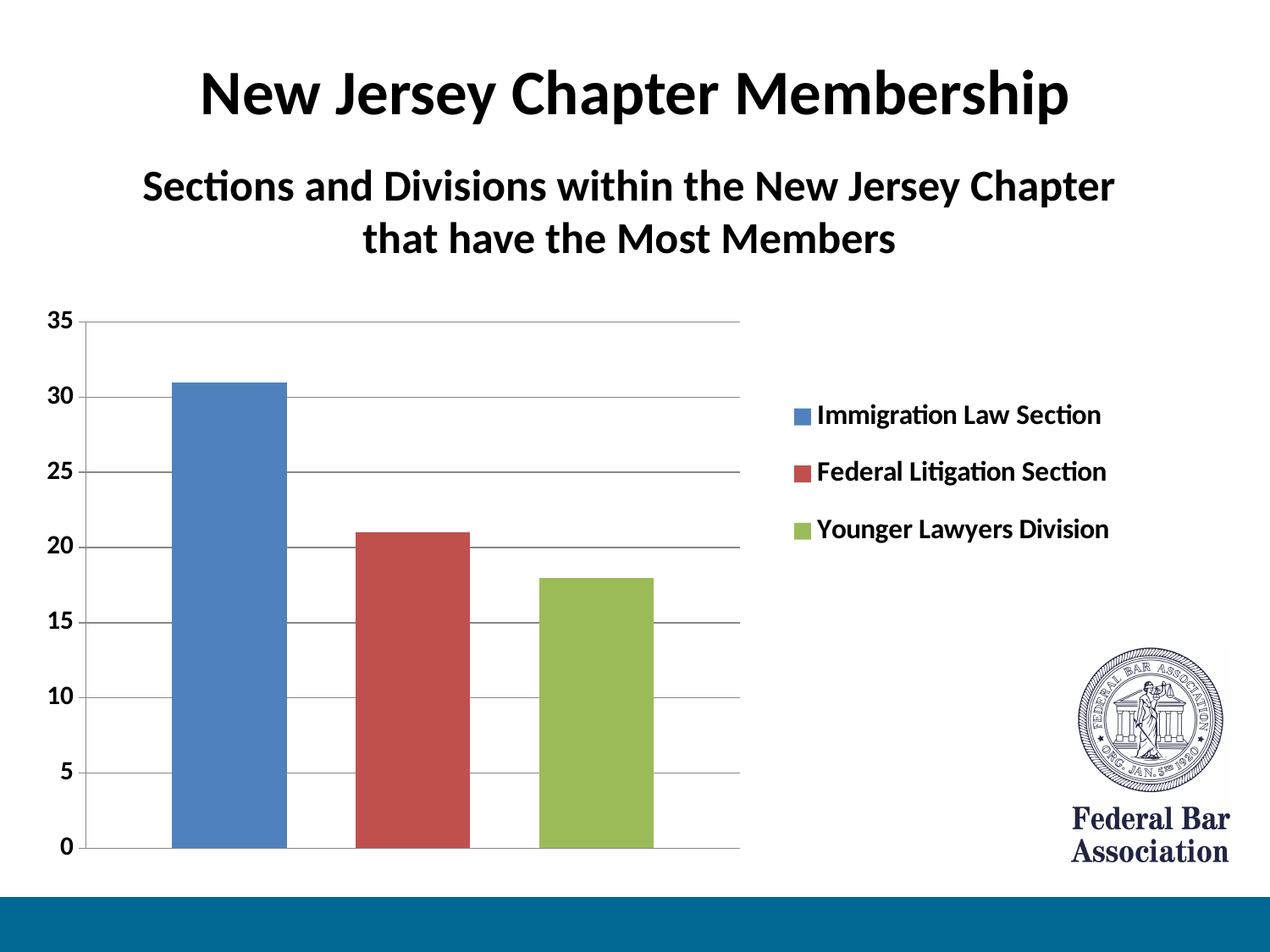
Which has more members, the Immigration Law Section or the Federal Litigation Section? Immigration Law Section What colour is the bar for the Federal Litigation Section? red Is the value for the Immigration Law Section greater or less than 25? greater Is the value for the Younger Lawyers Division greater or less than 15? greater Is the value for the Federal Litigation Section greater or less than 25? less Which has more members, the Federal Litigation Section or the Younger Lawyers Division? Federal Litigation Section How many series does the legend list? 3 What type of chart is shown on the slide? bar chart Which section or division has the highest membership in the chart? Immigration Law Section How many bars are plotted in the chart? 3 Which section or division has the lowest membership in the chart? Younger Lawyers Division